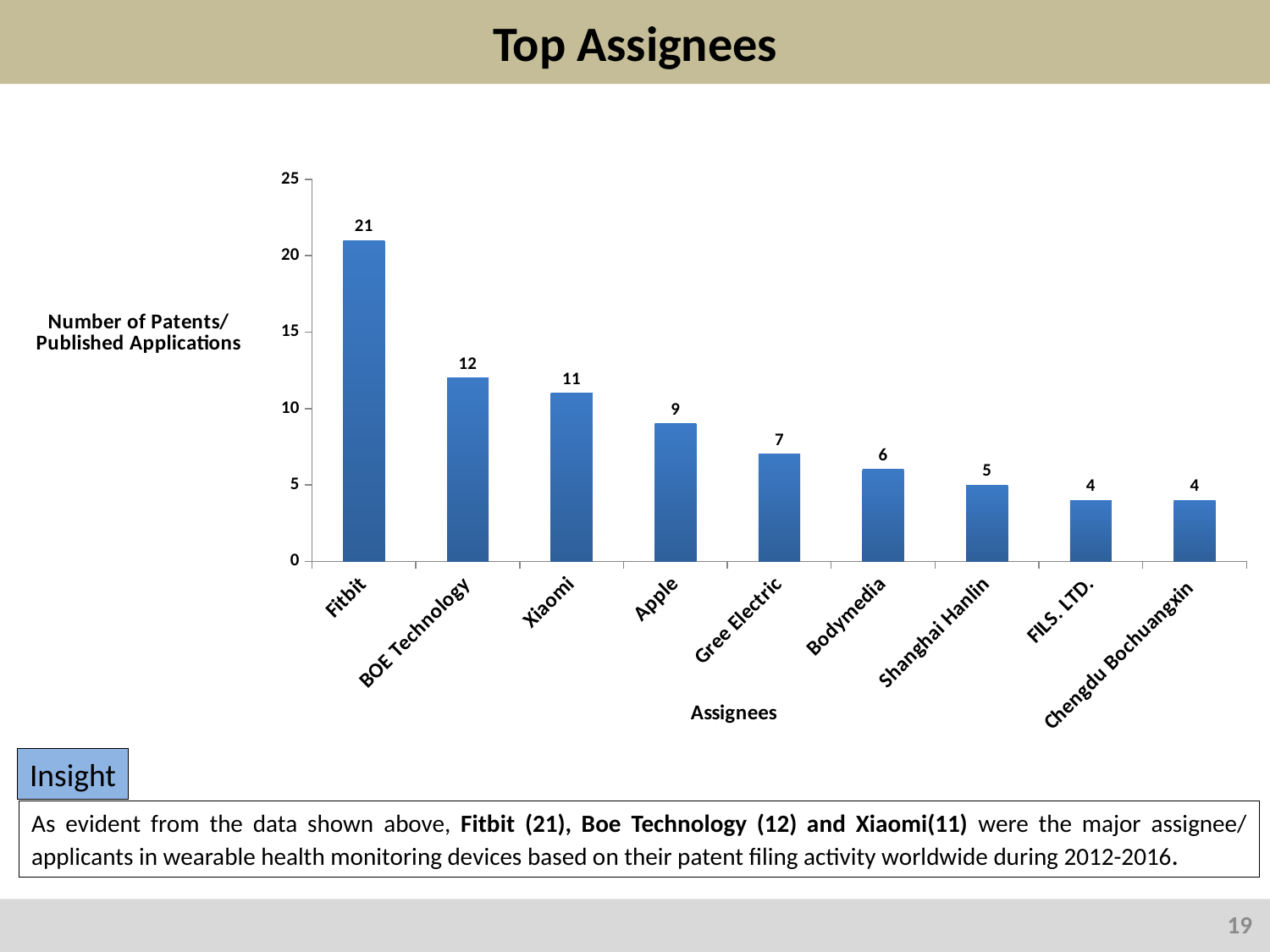
Which has a larger value, Xiaomi or Apple? Xiaomi What is the value shown for Shanghai Hanlin? 5 What is the value shown for Gree Electric? 7 What is the difference between the values for Fitbit and BOE Technology? 9 What is the difference between the values for Apple and Bodymedia? 3 Which assignee has the highest number of patents/published applications? Fitbit What kind of chart is shown on the slide? Bar chart How many patents/published applications does Fitbit have? 21 How many assignees are shown on the chart? 9 Is the value for BOE Technology greater or less than 10? greater What is the label of the x axis? Assignees Do the values rise or fall moving from left to right along the x axis? Fall